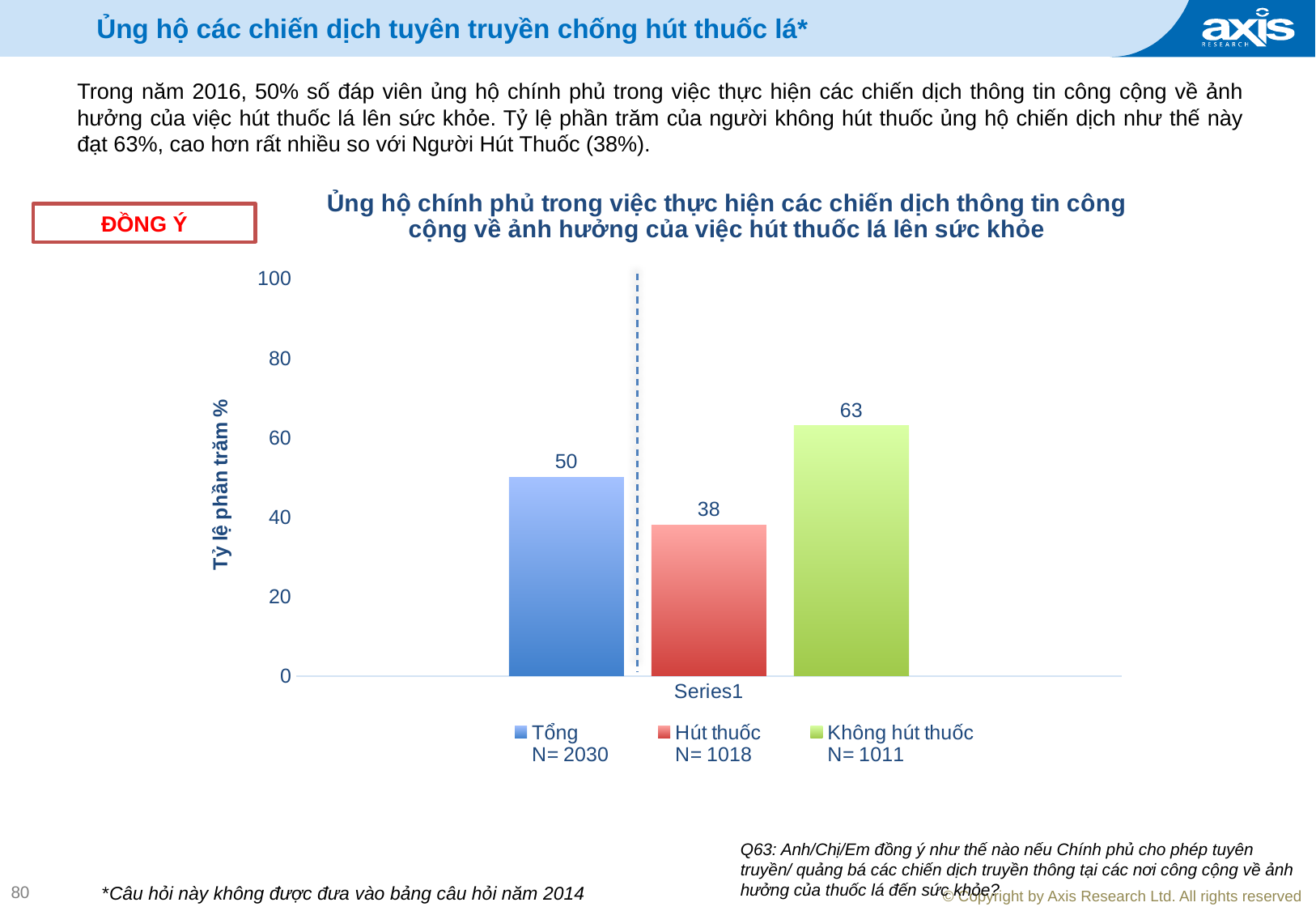
How many series does the legend list? 3 Which group has the lowest value? Hút thuốc What is the value for Hút thuốc (N= 1018)? 38 What kind of chart is shown? bar chart What is the label on the vertical axis? Tỷ lệ phần trăm % Which group has the highest value? Không hút thuốc Is the value for Hút thuốc greater or less than 40? less What is the value for Tổng (N= 2030)? 50 What is the difference between the values for Không hút thuốc and Tổng? 13 What is the value for Không hút thuốc (N= 1011)? 63 Which is larger, the value for Tổng or the value for Hút thuốc? Tổng What is the difference between the values for Không hút thuốc and Hút thuốc? 25